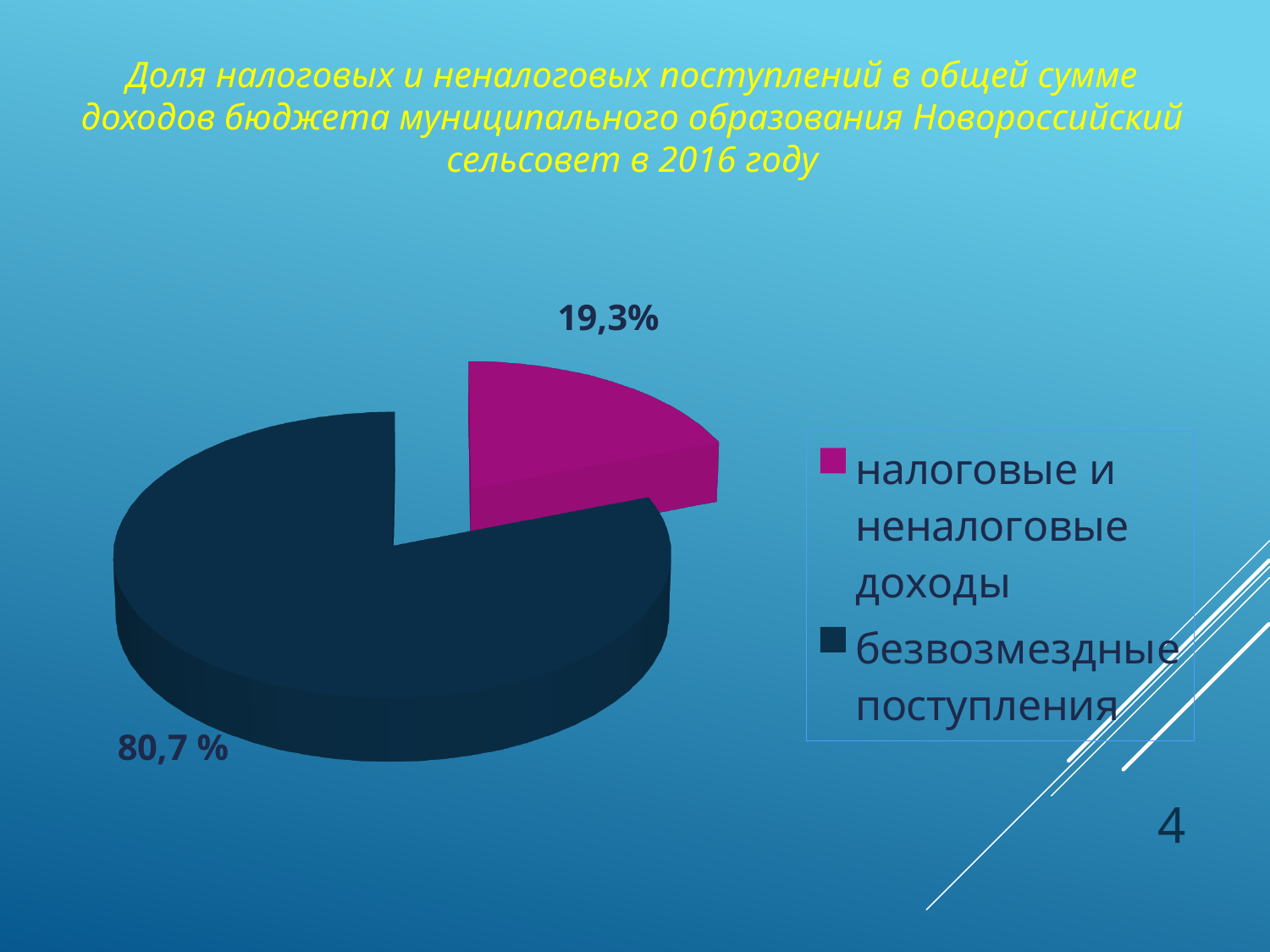
What kind of chart is shown on the slide? pie chart How many entries does the legend list? 2 How many slices does the pie chart have? 2 Which is larger: the slice for 'налоговые и неналоговые доходы' or the slice for 'безвозмездные поступления'? безвозмездные поступления Which year does the chart title refer to? 2016 What is the difference in percentage points between the 'безвозмездные поступления' slice and the 'налоговые и неналоговые доходы' slice? 61,4 Which category has the largest slice of the pie? безвозмездные поступления What share of the pie is labelled for 'безвозмездные поступления'? 80,7 % What colour is the slice for 'налоговые и неналоговые доходы'? magenta Which category has the smallest slice of the pie? налоговые и неналоговые доходы What share of the pie is labelled for 'налоговые и неналоговые доходы'? 19,3%